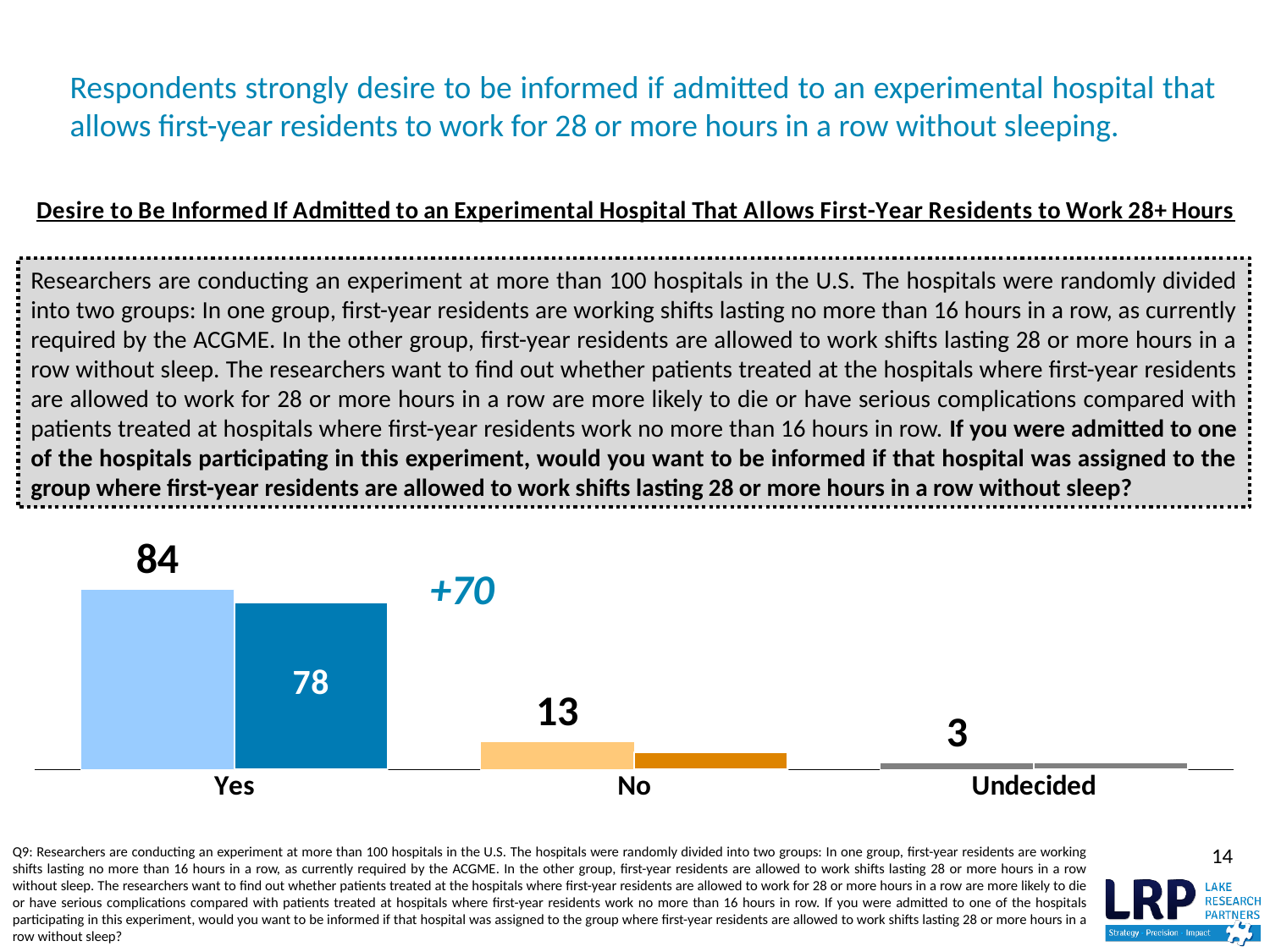
What is the value printed above the light blue bar for Yes? 84 What is the value printed on the dark blue bar for Yes? 78 What annotation is printed in italics next to the Yes bars? +70 What is the difference between the light blue Yes value (84) and the light orange No value (13)? 71 What kind of chart is shown on the slide? bar chart What is the value printed above the bar for Undecided? 3 What is the chart's title? Desire to Be Informed If Admitted to an Experimental Hospital That Allows First-Year Residents to Work 28+ Hours What is the value printed above the light orange bar for No? 13 How many categories are shown on the x axis of the chart? 3 Which category has the highest value in the chart? Yes Which is larger, the light orange No value or the Undecided value? No Which category has the lowest value in the chart? Undecided